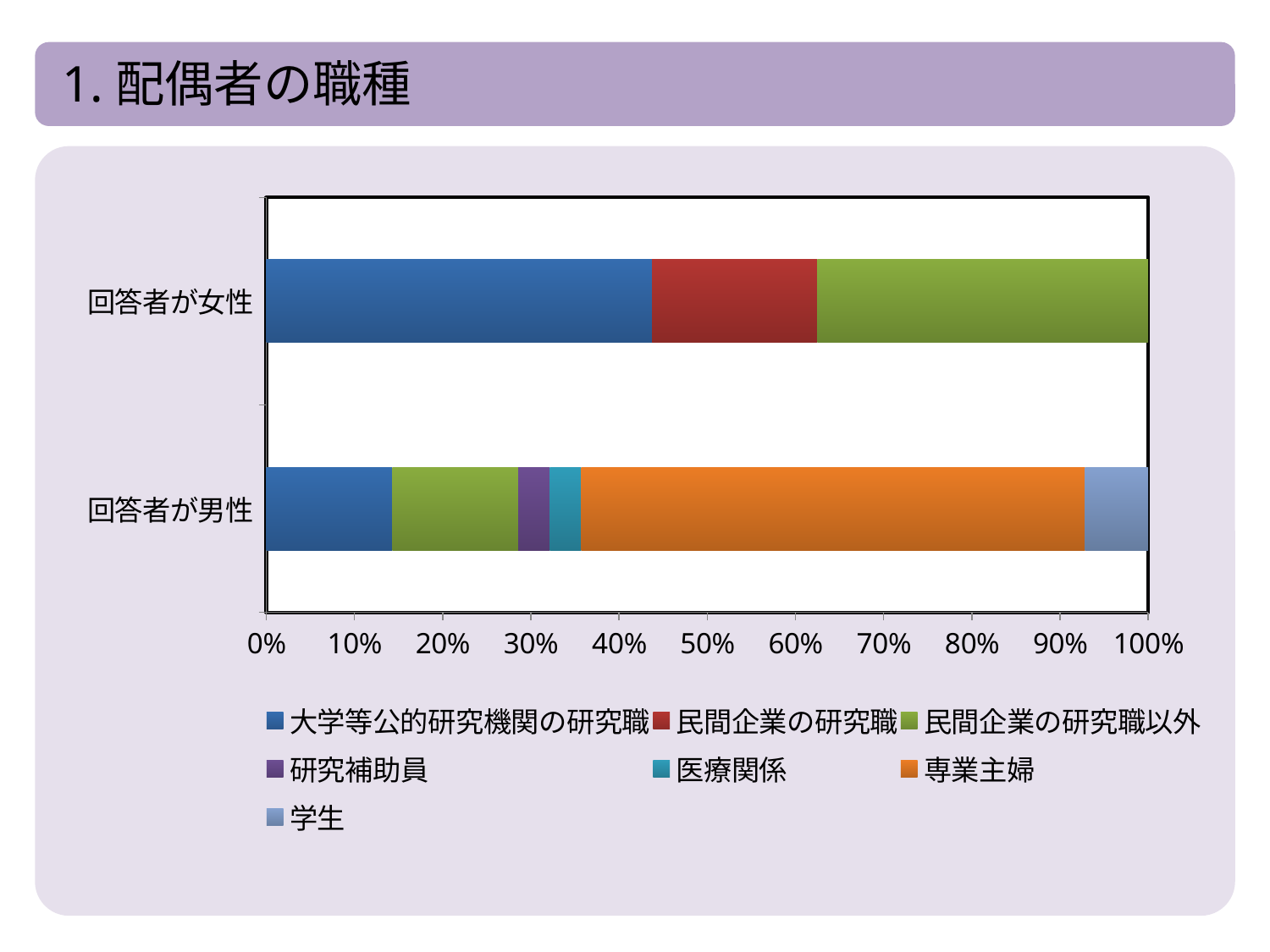
Which legend entry is shown in orange? 専業主婦 How many categories (bars) does the chart show? 2 Which segment is the largest in the 回答者が男性 bar? 専業主婦 Which segment is the largest in the 回答者が女性 bar? 大学等公的研究機関の研究職 How many series does the legend list? 7 Is the share of 大学等公的研究機関の研究職 for 回答者が男性 greater or less than 20%? less Is the share of 専業主婦 for 回答者が男性 greater or less than 50%? greater What is the title of the slide containing the chart? 1. 配偶者の職種 Is the share of 大学等公的研究機関の研究職 for 回答者が女性 greater or less than 40%? greater What kind of chart is shown on the slide? stacked bar chart Which bar has the larger share of 大学等公的研究機関の研究職, 回答者が女性 or 回答者が男性? 回答者が女性 Which bar has the larger share of 民間企業の研究職以外, 回答者が女性 or 回答者が男性? 回答者が女性